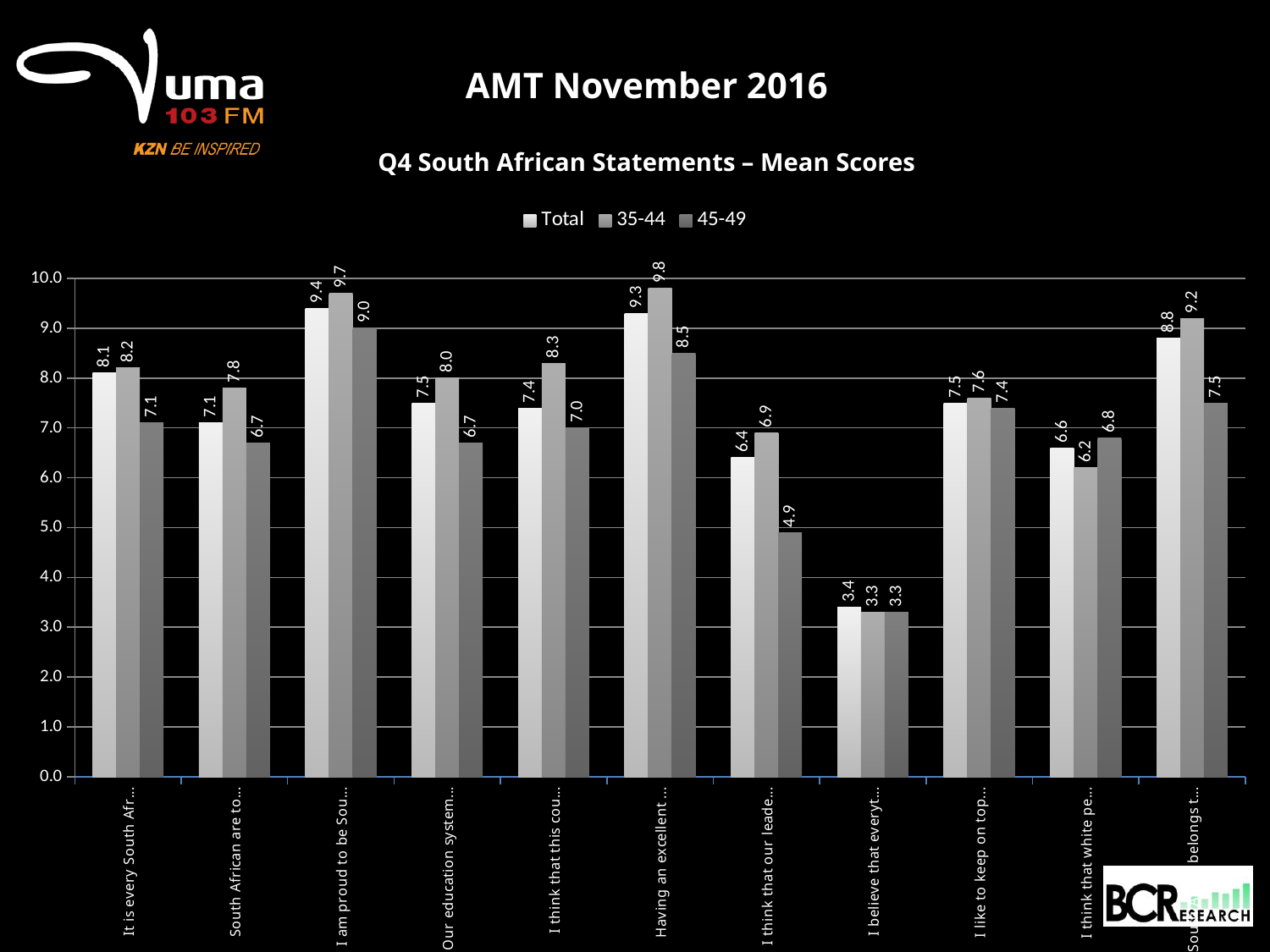
What is the difference between the Total scores for "I am proud to be Sou..." and "Our education system..."? 1.9 What is the difference between the 35-44 and 45-49 mean scores for the statement beginning "I think that our leade..."? 2.0 How many series does the legend list? 3 What is the 45-49 mean score for the statement beginning "I think that our leade..."? 4.9 Which statement has the lowest Total mean score? I believe that everyt... What type of chart is shown on the slide? bar chart What is the title of the chart? Q4 South African Statements – Mean Scores What is the 35-44 mean score for the statement beginning "Having an excellent..."? 9.8 Which statement has the highest 35-44 mean score? Having an excellent... How many statement categories are plotted along the x axis? 11 What is the Total mean score for the statement beginning "I am proud to be Sou..."? 9.4 For the statement beginning "I think that white pe...", which is larger: the Total score or the 45-49 score? 45-49